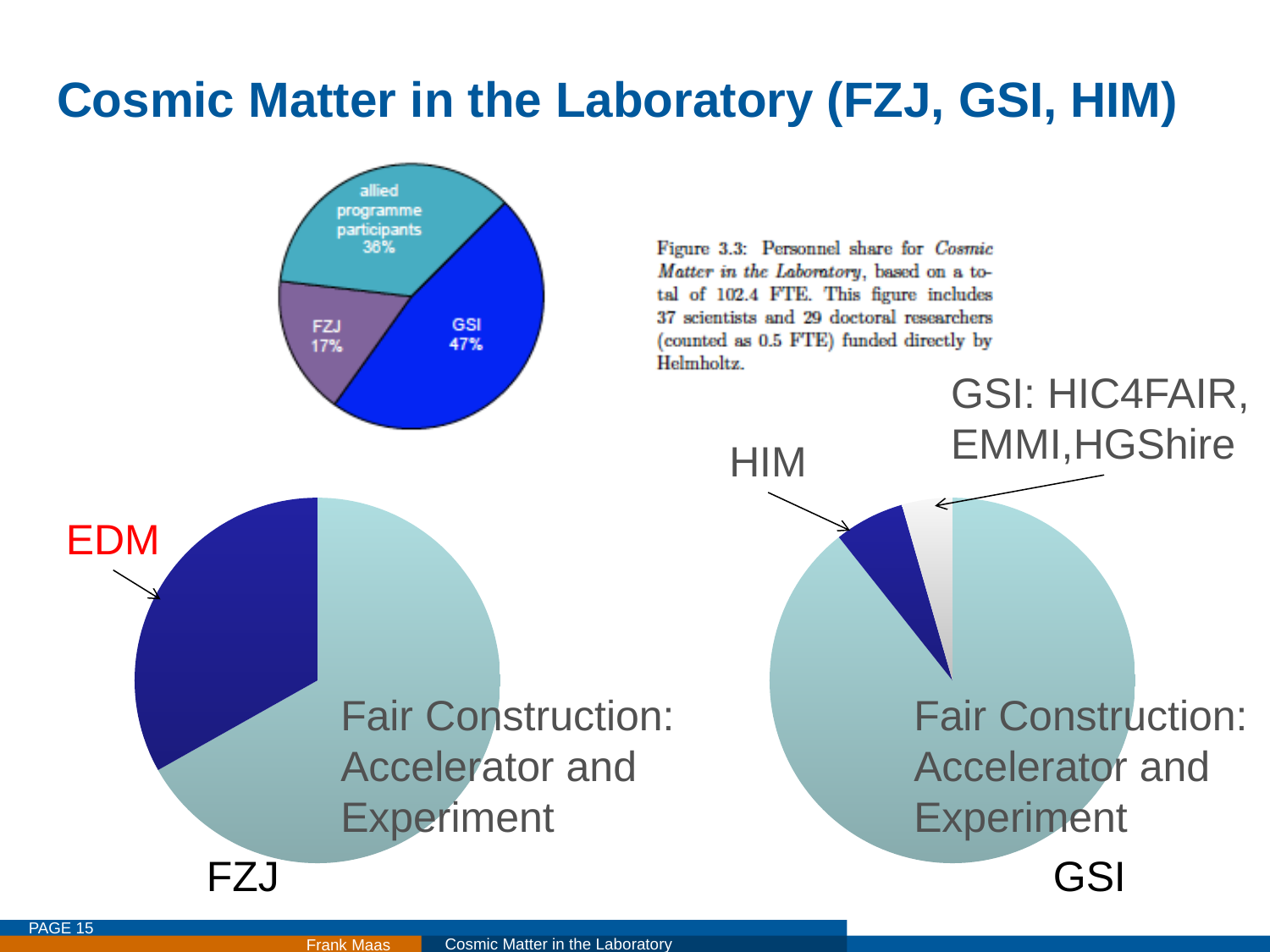
In the top pie chart (Figure 3.3), what is the difference in percentage points between the GSI share and the FZJ share? 30 percentage points In the top pie chart (Figure 3.3), what is the personnel share for GSI? 47% In the top pie chart (Figure 3.3), which category has the smallest share? FZJ How many slices does the bottom-right pie chart labelled GSI have? 3 In the top pie chart (Figure 3.3), which is larger: the share for GSI or the share for allied programme participants? GSI How many slices does the top pie chart (Figure 3.3) have? 3 What kind of chart is the bottom-left chart labelled FZJ? Pie chart In the top pie chart (Figure 3.3), what is the share for allied programme participants? 36% In the bottom-right pie chart labelled GSI, which slice is the largest? Fair Construction: Accelerator and Experiment In the top pie chart (Figure 3.3), which category has the largest share? GSI In the top pie chart (Figure 3.3), what is the personnel share for FZJ? 17% In the bottom-left pie chart labelled FZJ, which slice is larger: EDM or Fair Construction: Accelerator and Experiment? Fair Construction: Accelerator and Experiment